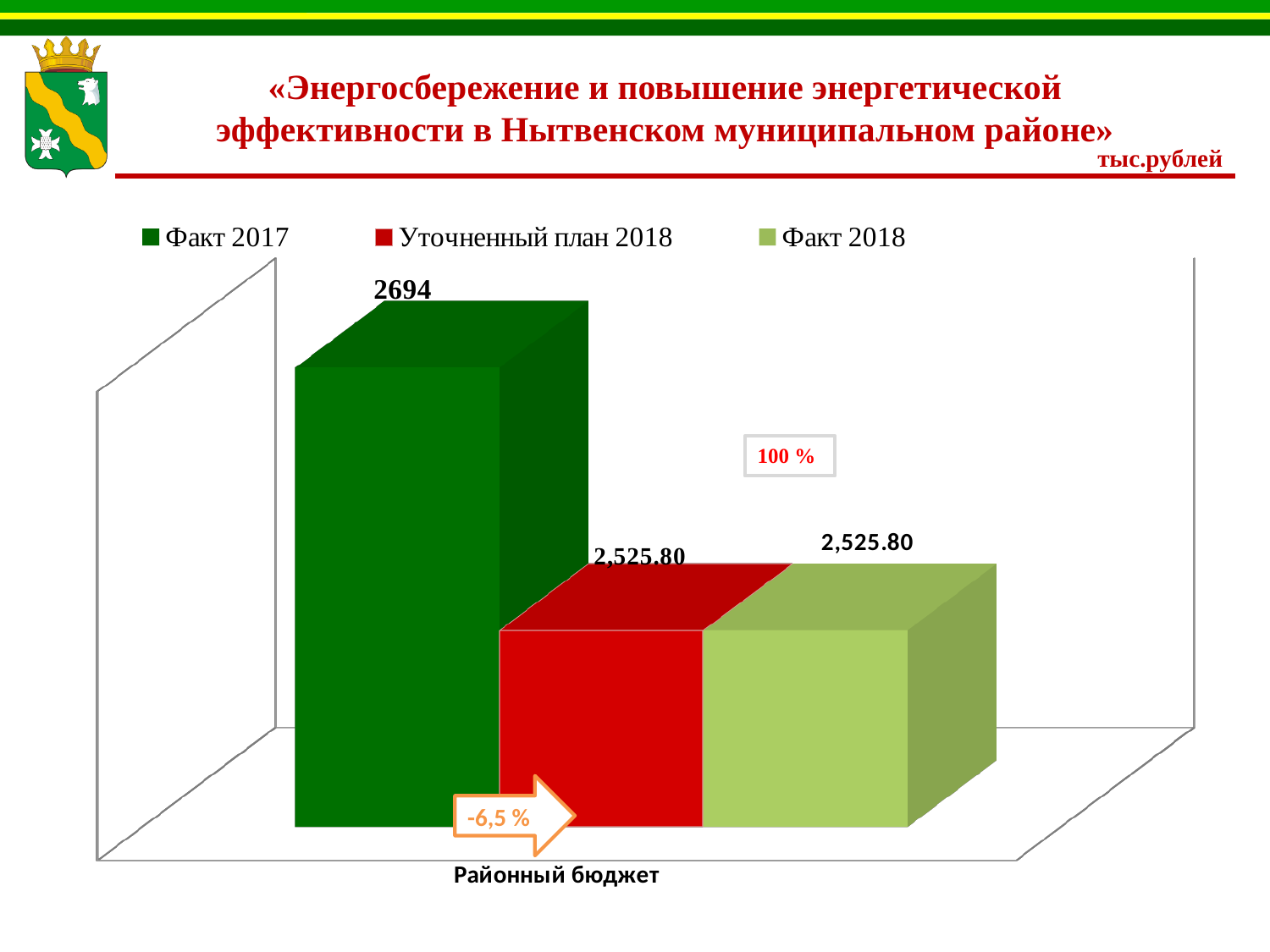
What percentage change is shown in the arrow annotation between Факт 2017 and the 2018 bars? -6,5 % What is the value for Факт 2018? 2,525.80 How many categories are shown on the x axis? 1 What is the name of the category shown on the x axis? Районный бюджет Do the values fall or rise from Факт 2017 to Уточненный план 2018? fall What kind of chart is shown on the slide? bar chart Which series has the highest value? Факт 2017 Which is larger, Факт 2017 or Факт 2018? Факт 2017 What unit of measurement is indicated for the chart values? тыс.рублей How many series does the legend list? 3 What is the value for Уточненный план 2018? 2,525.80 What is the value for Факт 2017 in the Районный бюджет category? 2694